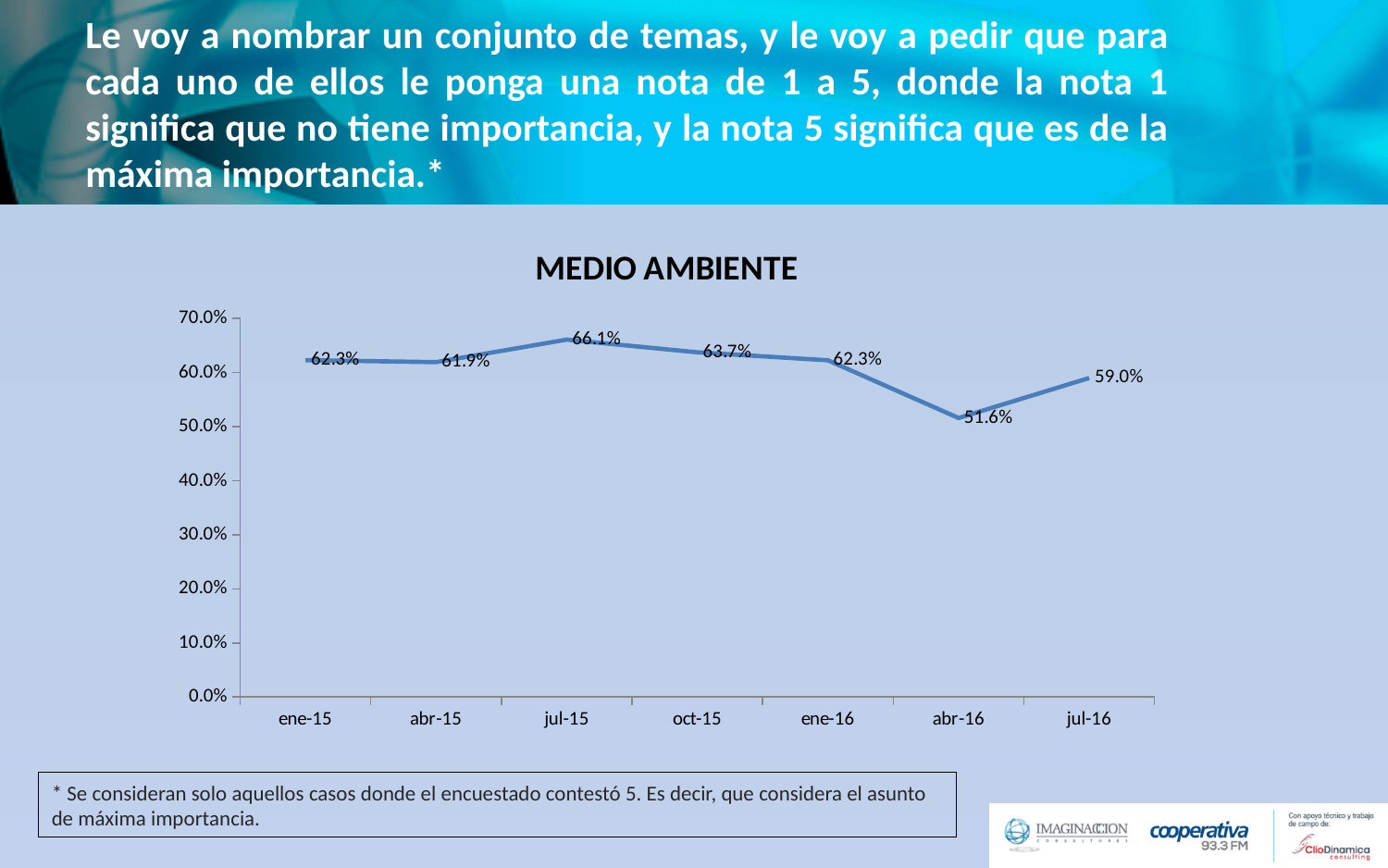
Is the value for abr-16 greater or less than 60.0%? less Which is larger, the value for oct-15 or the value for jul-16? oct-15 How many periods are shown on the x axis? 7 What is the title of the chart? MEDIO AMBIENTE Which period has the highest value? jul-15 Which period has the lowest value? abr-16 What kind of chart is shown? line chart What is the value for abr-16? 51.6% What is the value for jul-15? 66.1% What is the value for jul-16? 59.0% What is the value for oct-15? 63.7% What is the difference between the values for jul-15 and abr-16? 14.5%